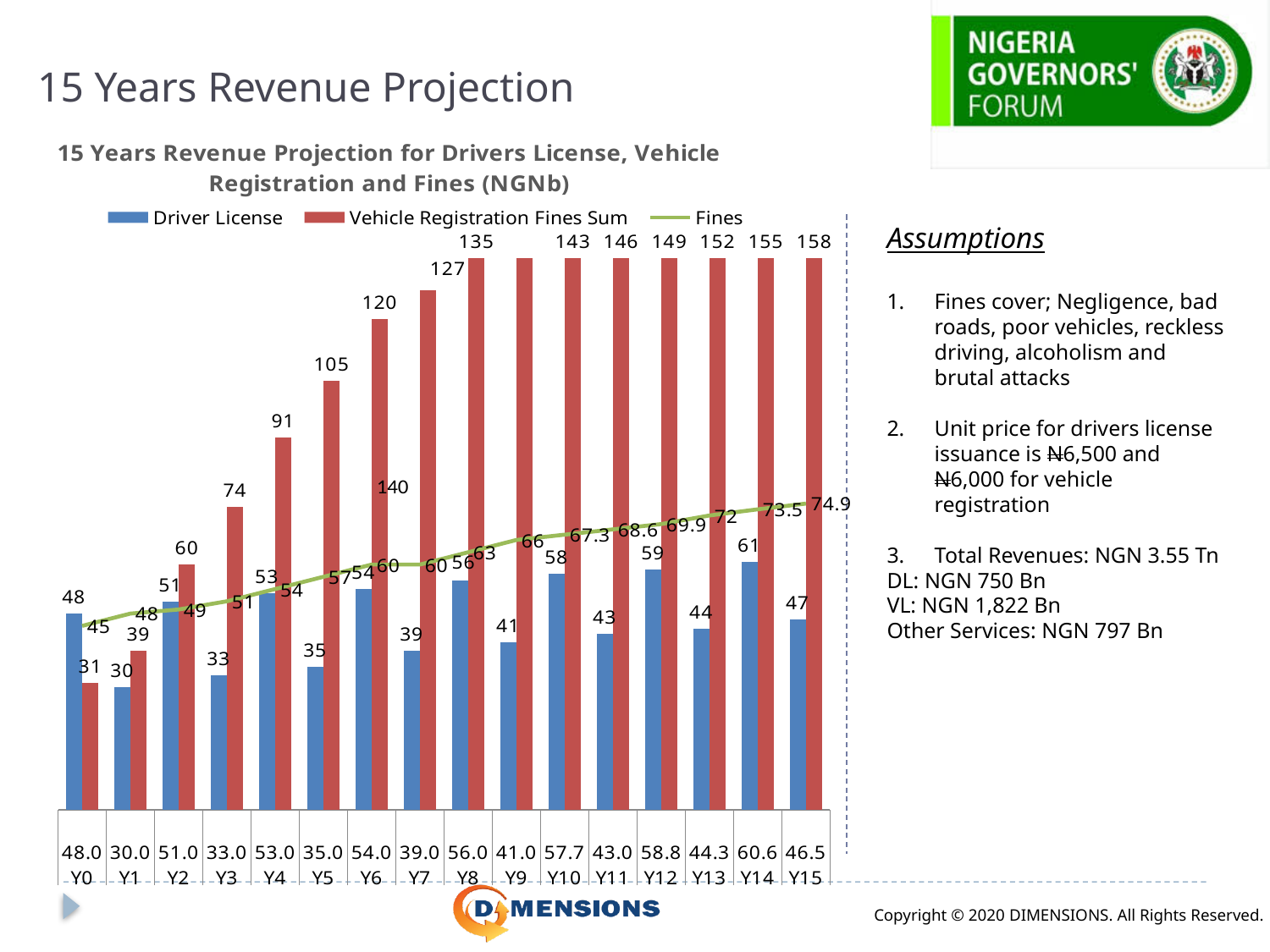
For Y1, which is larger: Driver License or Vehicle Registration Fines Sum? Vehicle Registration Fines Sum What is the Fines value for Y15? 74.9 What kind of chart is shown on the slide? bar chart with a line How many series does the legend list? 3 In which year is the Vehicle Registration Fines Sum lowest? Y0 Does the Vehicle Registration Fines Sum rise or fall from Y0 to Y15? rise In which year is the Vehicle Registration Fines Sum highest? Y15 What is the Driver License value for Y0? 48 How many year categories are plotted along the x axis? 16 What is the Vehicle Registration Fines Sum value for Y15? 158 In which year is the Driver License value highest? Y14 What is the difference between the Vehicle Registration Fines Sum for Y15 and for Y0? 127